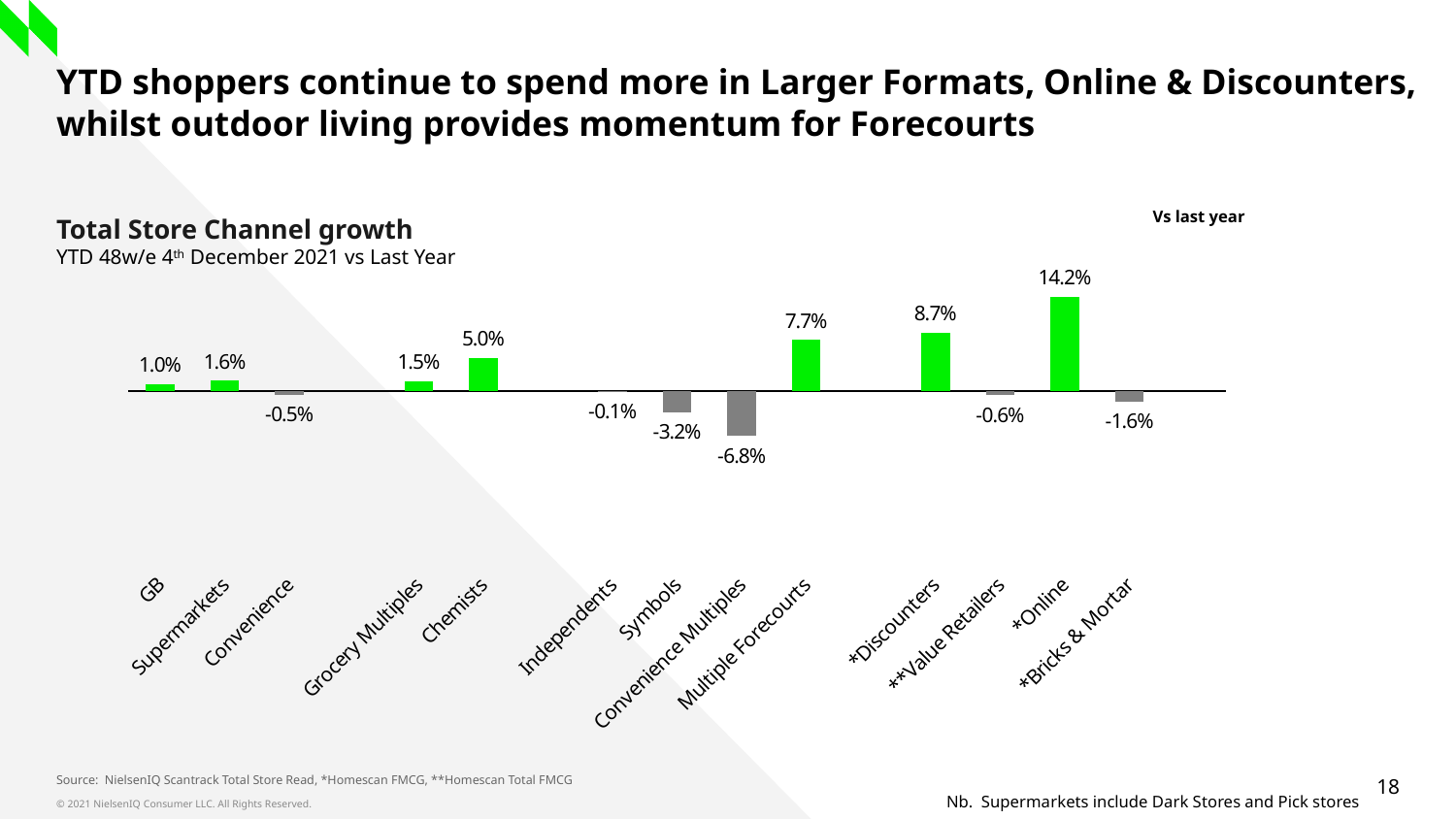
Which has higher growth, Supermarkets or Grocery Multiples? Supermarkets Which channel has the highest growth? *Online What is the growth value for Multiple Forecourts? 7.7% What kind of chart is shown on the slide? Bar chart What is the difference between the growth for *Online and *Discounters? 5.5% How many channels are shown on the chart? 13 What is the growth value for Convenience Multiples? -6.8% What is the growth value for *Online? 14.2% What is the title of the chart? Total Store Channel growth Which channel has the lowest growth? Convenience Multiples What is the growth value for Chemists? 5.0% What colour are the bars with negative values? Grey